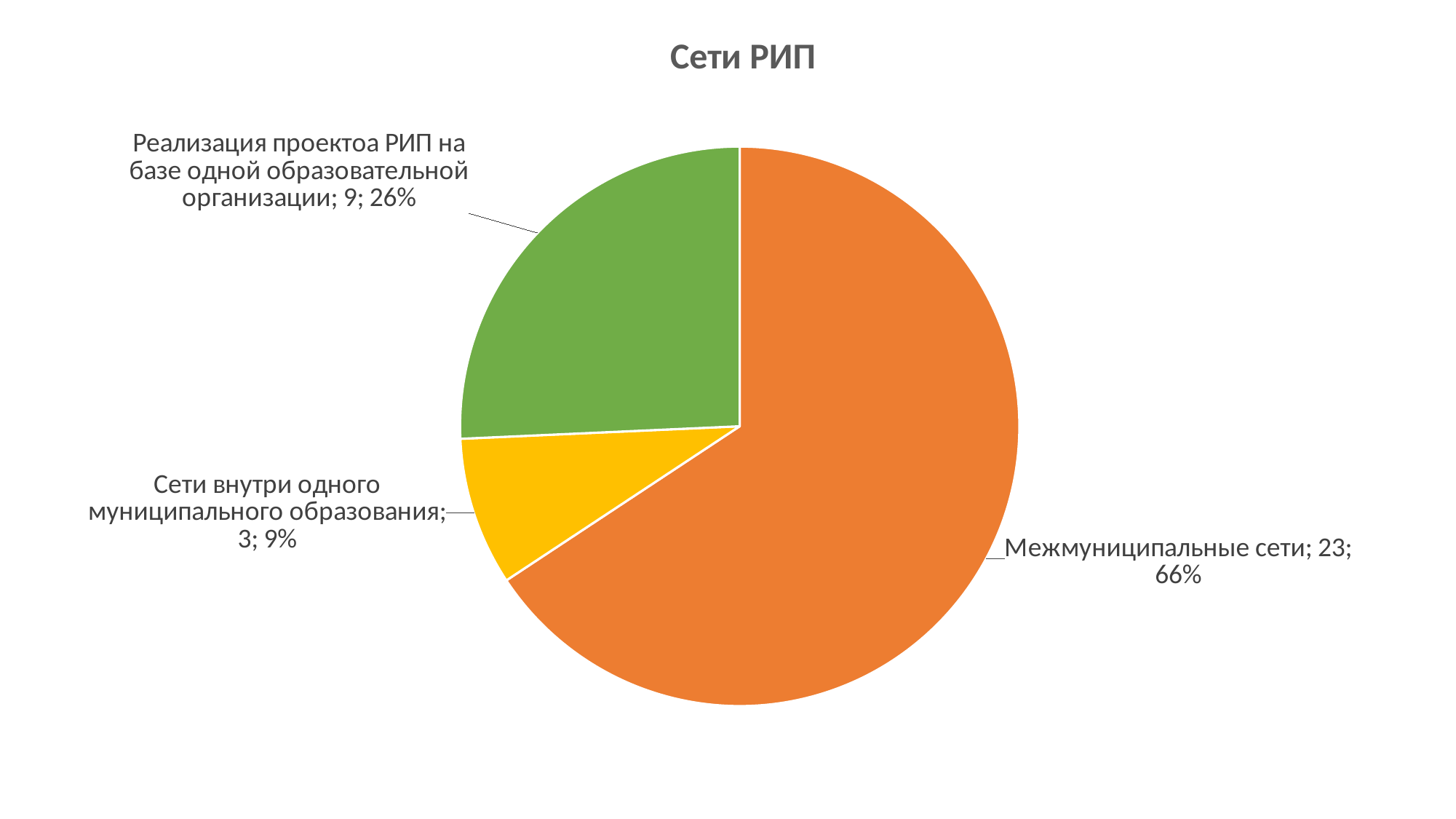
What is the value for Сети внутри одного муниципального образования? 3 What share of the pie does Реализация проектоа РИП на базе одной образовательной организации take? 26% What share of the pie does Межмуниципальные сети take? 66% How many slices does the pie chart have? 3 Which category has the smallest slice? Сети внутри одного муниципального образования What is the difference between the values for Межмуниципальные сети and Реализация проектоа РИП на базе одной образовательной организации? 14 What is the title of the chart? Сети РИП Which colour is the slice for Сети внутри одного муниципального образования? yellow What kind of chart is shown on the slide? pie chart What is the value for Реализация проектоа РИП на базе одной образовательной организации? 9 What is the value for Межмуниципальные сети? 23 Which category has the largest slice? Межмуниципальные сети